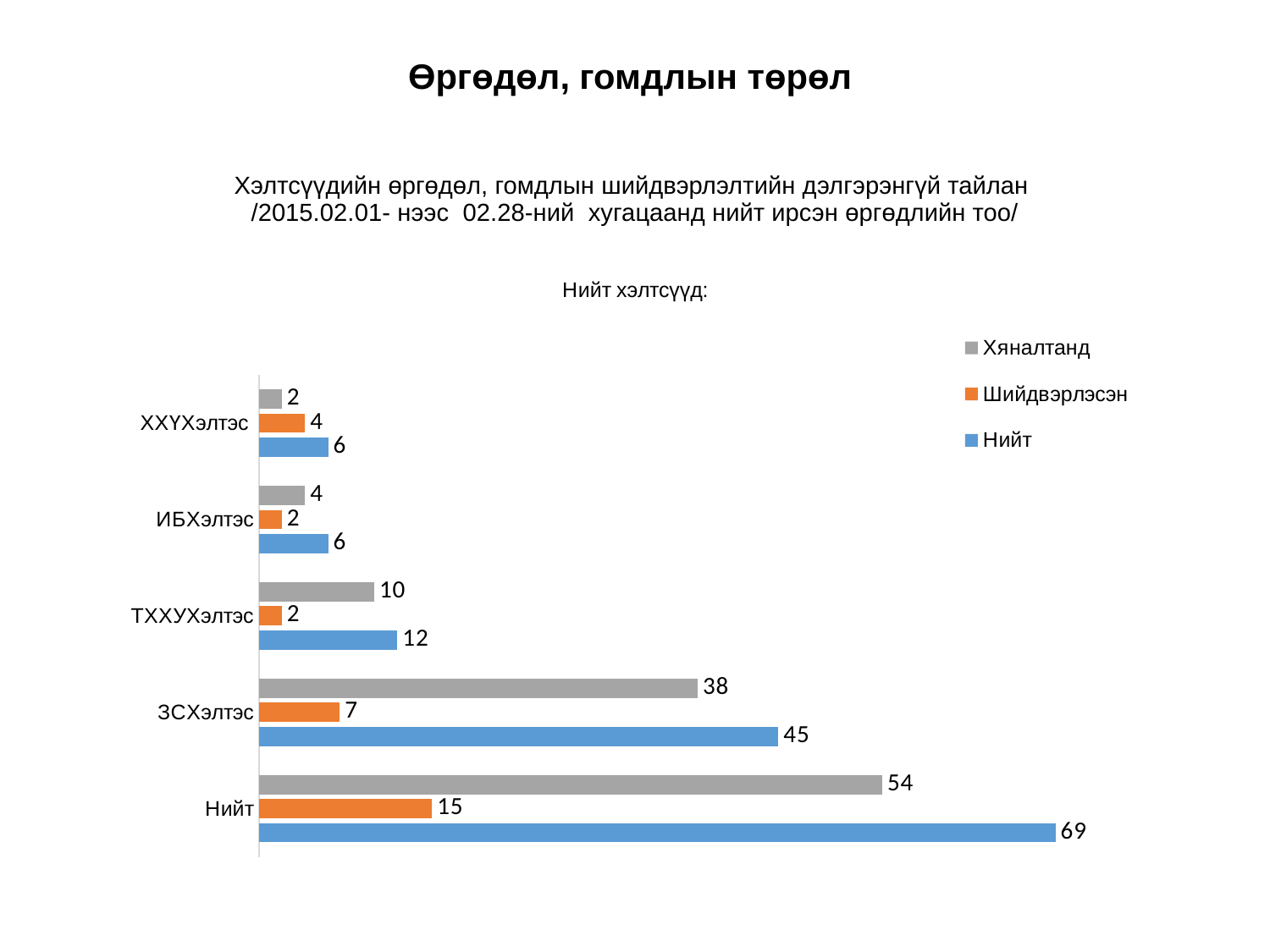
What colour are the Шийдвэрлэсэн bars? Orange Which is larger for ИБХэлтэс: the Хяналтанд value or the Шийдвэрлэсэн value? Хяналтанд What is the Нийт value for ЗСХэлтэс? 45 Which category has the lowest Хяналтанд value? ХХҮХэлтэс What is the difference between the Нийт values for ЗСХэлтэс and ТХХУХэлтэс? 33 Which category has the highest Хяналтанд value? Нийт What is the Хяналтанд value for ТХХУХэлтэс? 10 What is the Шийдвэрлэсэн value for ХХҮХэлтэс? 4 What is the Шийдвэрлэсэн value for Нийт? 15 What kind of chart is shown on the slide? Bar chart How many categories are shown on the chart? 5 How many series does the legend list? 3